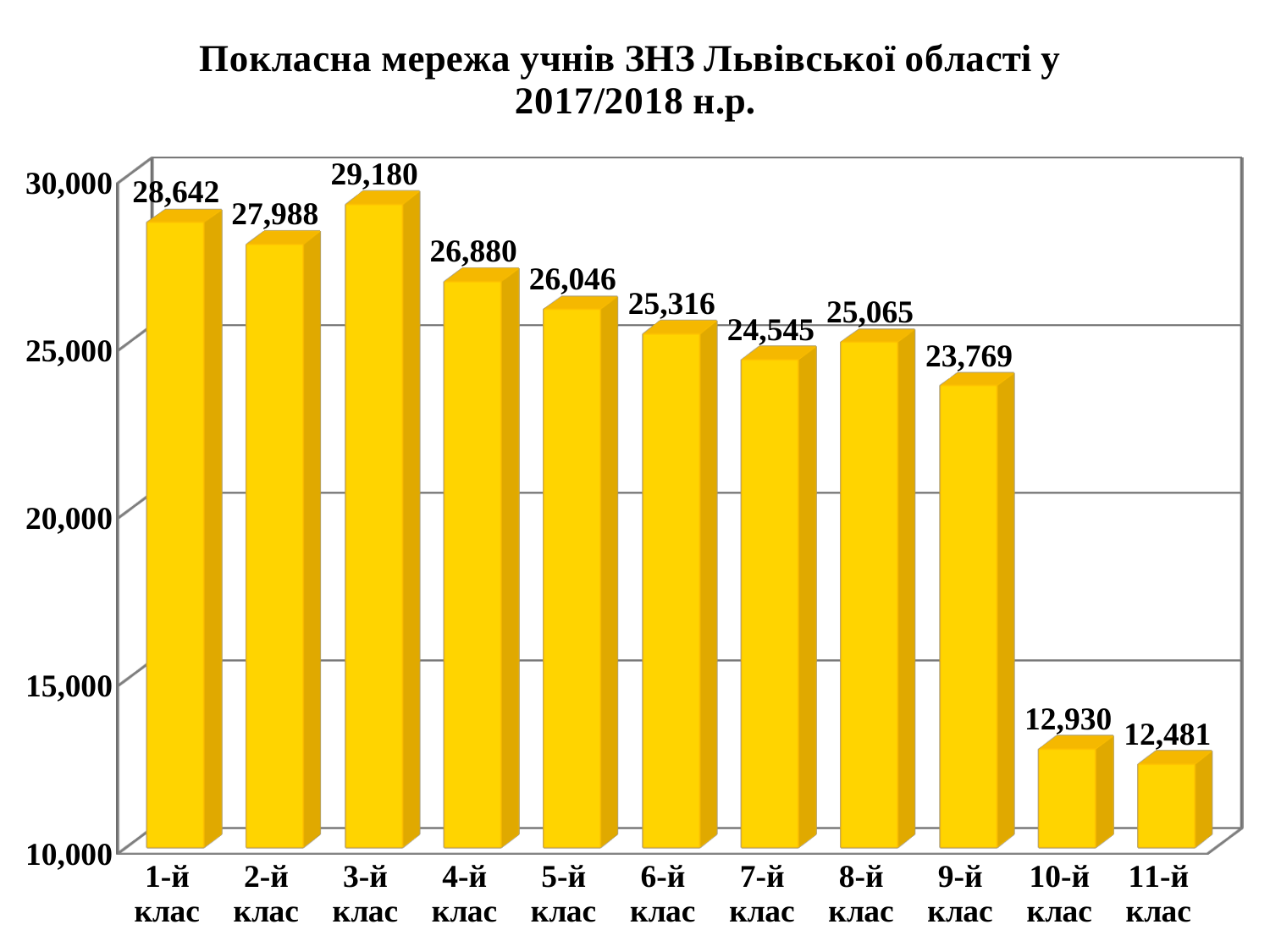
Which class has the highest value? 3-й клас What is the value for 3-й клас? 29,180 What is the title of the chart? Покласна мережа учнів ЗНЗ Львівської області у 2017/2018 н.р. What kind of chart is shown on the slide? bar chart What is the value for 9-й клас? 23,769 What is the difference between the values for 10-й клас and 11-й клас? 449 Which is larger, the value for 7-й клас or the value for 8-й клас? 8-й клас Is the value for 4-й клас greater or less than 25,000? greater How many classes are shown on the chart? 11 What is the value for 11-й клас? 12,481 What is the difference between the values for 1-й клас and 2-й клас? 654 Which class has the lowest value? 11-й клас